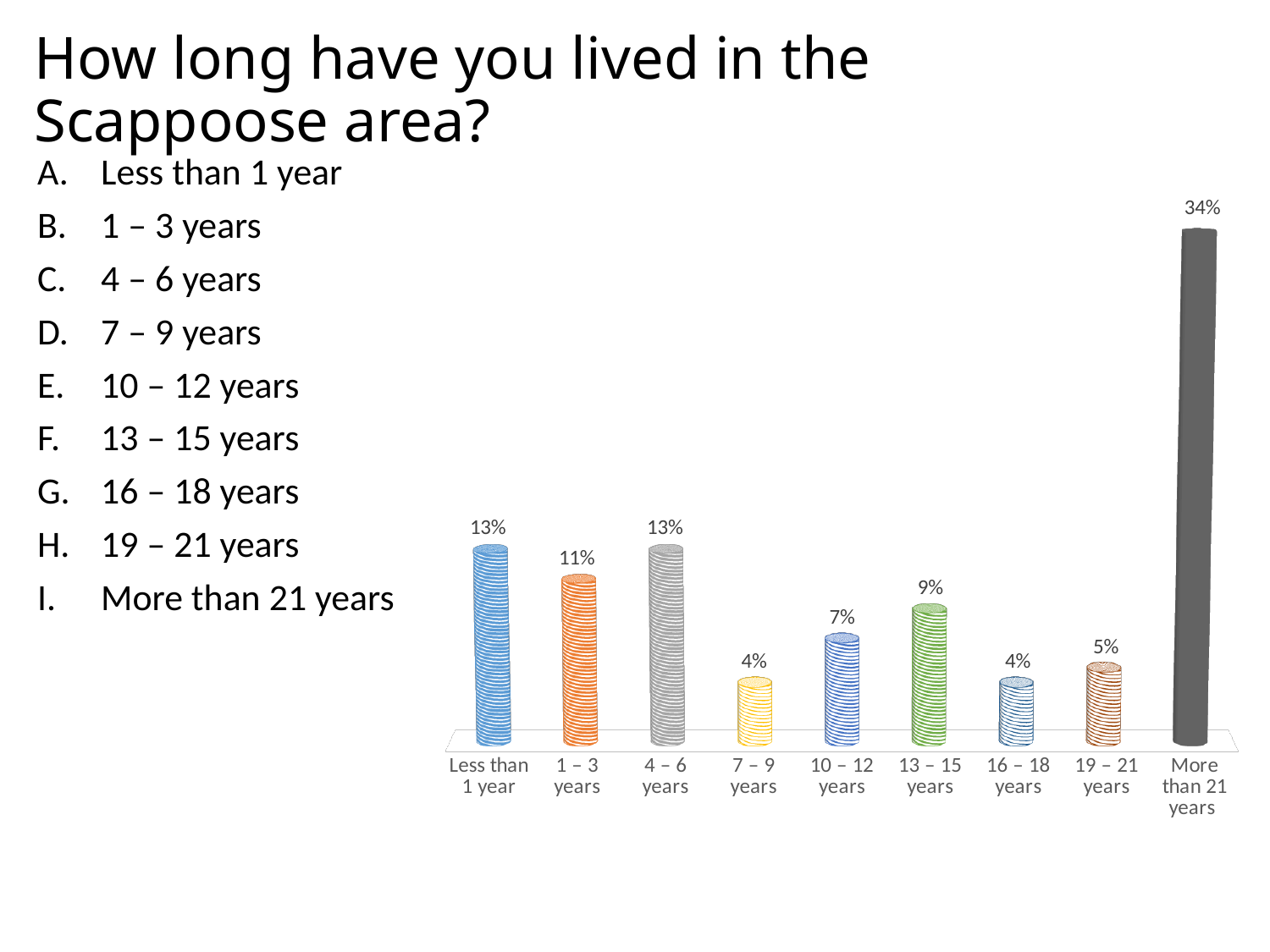
What is the value shown for the 13 – 15 years category? 9% Which two categories share the lowest value of 4%? 7 – 9 years and 16 – 18 years What is the difference between the value for More than 21 years and the value for Less than 1 year? 21% What question does the slide title ask? How long have you lived in the Scappoose area? What kind of chart is shown on the slide? Bar chart What is the value shown for the 1 – 3 years category? 11% What percentage of respondents have lived in the Scappoose area for more than 21 years? 34% How many categories are shown on the x axis of the chart? 9 What is the difference between the value for 10 – 12 years and the value for 19 – 21 years? 2% Which category has the highest value? More than 21 years What is the value shown for the 19 – 21 years category? 5% Which is larger, the value for 4 – 6 years or the value for 13 – 15 years? 4 – 6 years